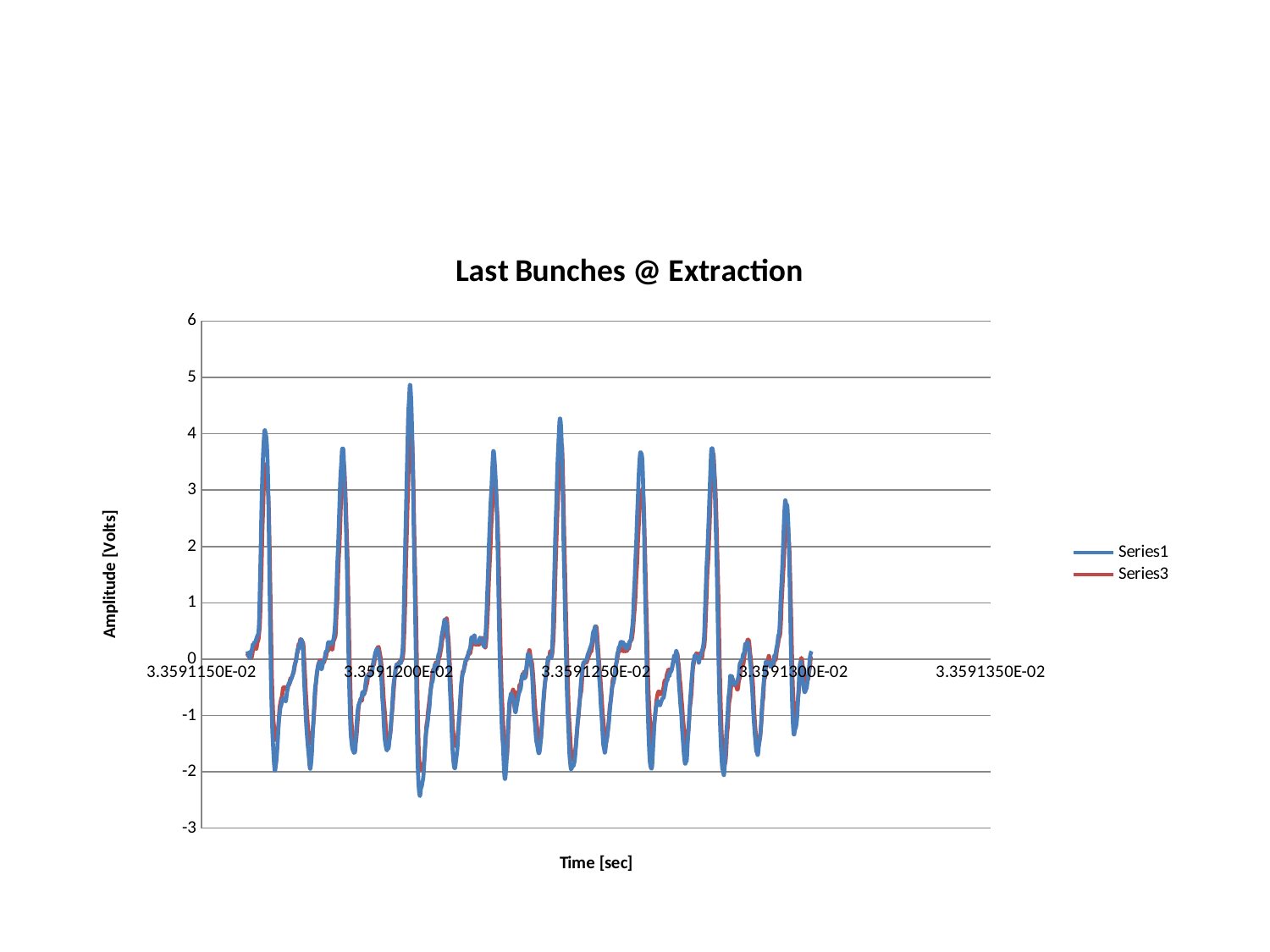
How many series does the legend list? 2 What is the first tick label shown on the horizontal axis? 3.3591150E-02 What is the label of the vertical axis? Amplitude [Volts] What is the highest value shown on the vertical axis? 6 Is the last (rightmost) major peak of Series1 greater or less than 3? less What is the label of the horizontal axis? Time [sec] Is the highest peak of Series1 greater or less than 4? greater What are the names of the series listed in the legend? Series1 and Series3 What is the title of the chart? Last Bunches @ Extraction What is the lowest value shown on the vertical axis? -3 What kind of chart is shown on the slide? Line chart Is the lowest trough of Series1 greater or less than -2? less